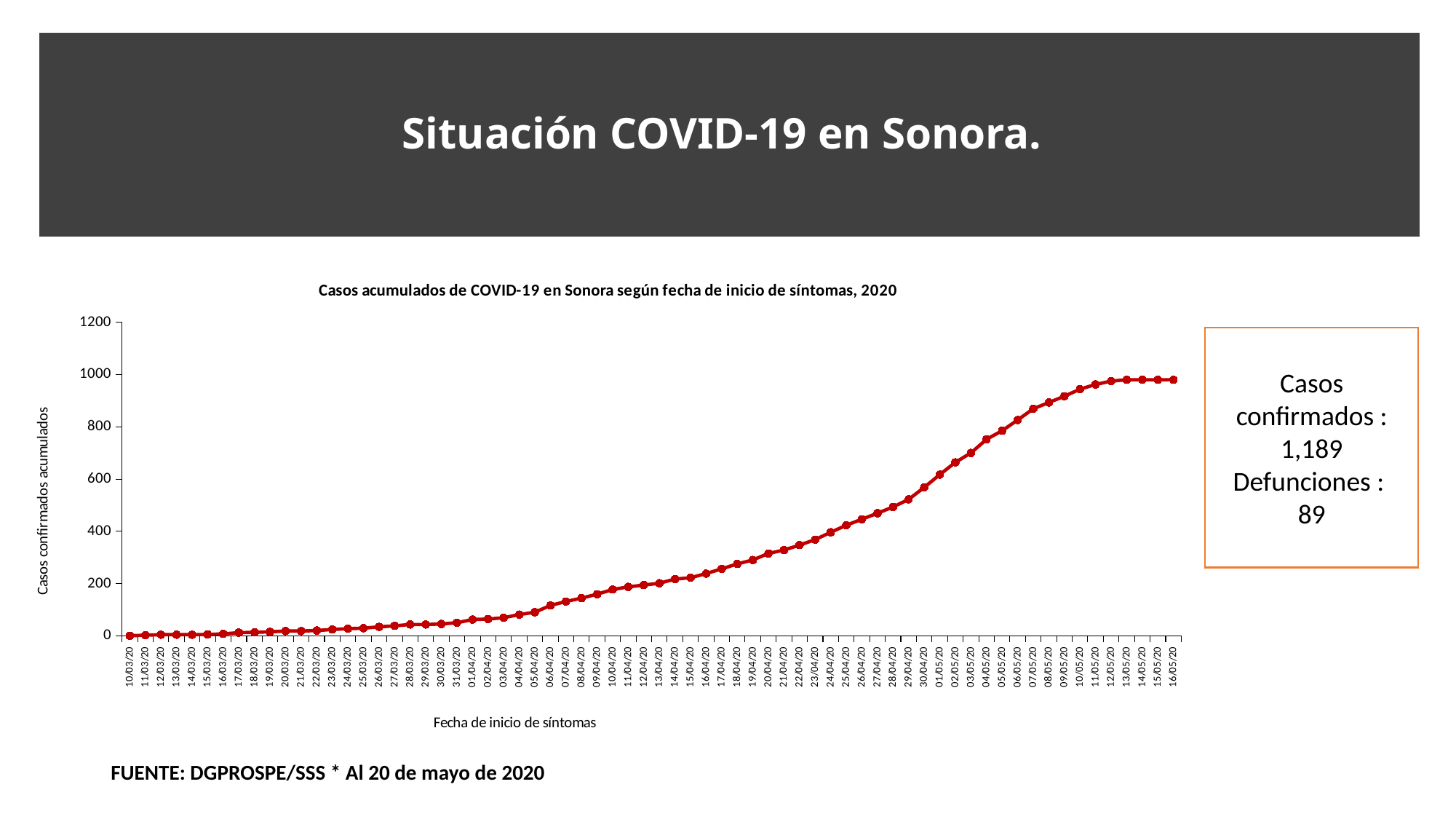
What is the label of the vertical axis of the chart? Casos confirmados acumulados What kind of chart is shown on the slide? line chart Do the values in the chart rise or fall from left to right along the x axis? rise Is the value for 01/04/20 greater or less than 200? less Is the value for 25/04/20 greater or less than 200? greater Is the value for 05/05/20 greater or less than 600? greater Which date has the lowest value in the chart? 10/03/20 Which is larger, the value for 30/04/20 or the value for 31/03/20? 30/04/20 What is the title of the chart? Casos acumulados de COVID-19 en Sonora según fecha de inicio de síntomas, 2020